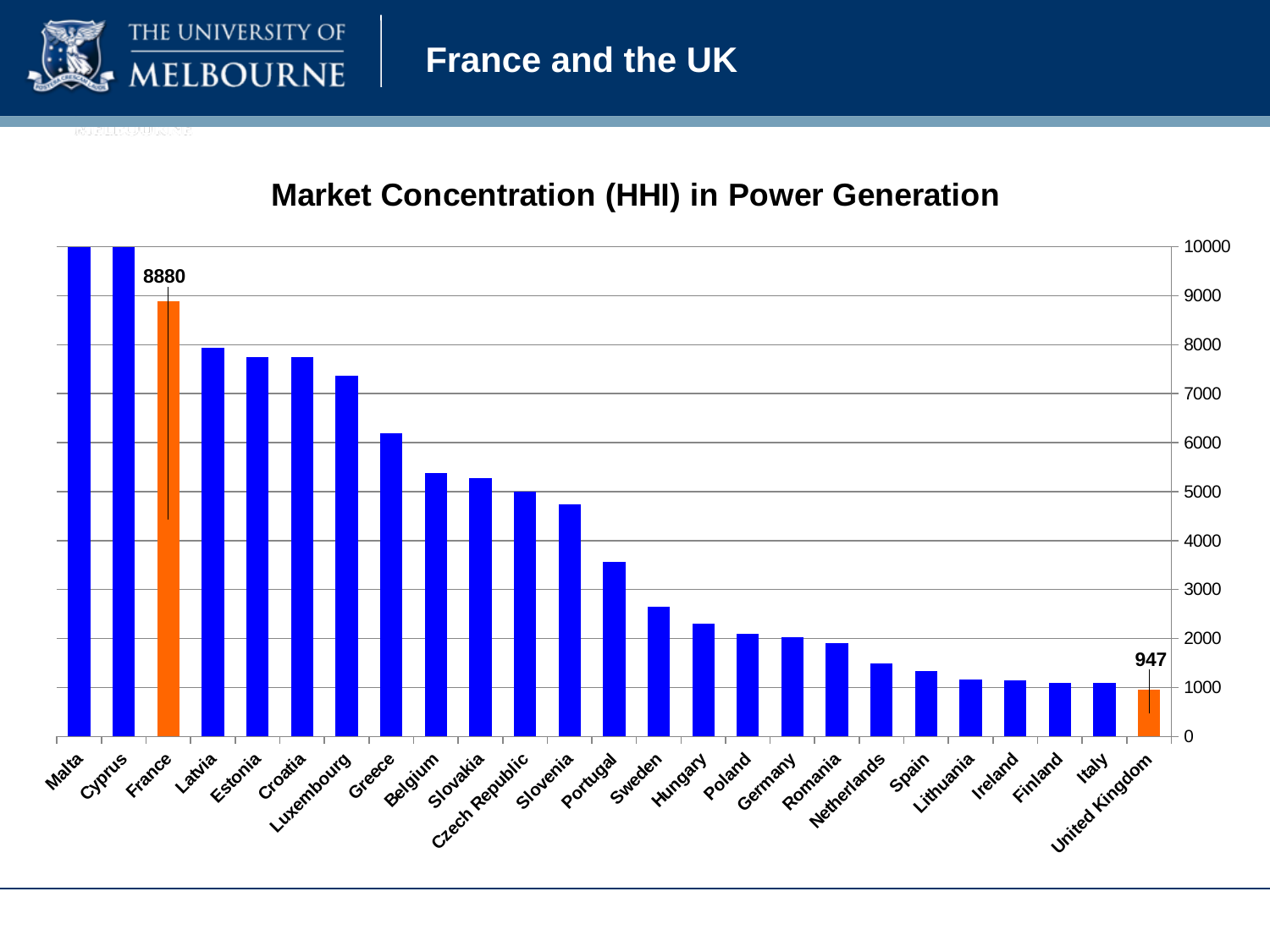
What is the HHI value shown for the United Kingdom? 947 What is the HHI value shown for France? 8880 Is the value for Latvia greater or less than 7000? greater What type of chart is shown on the slide? bar chart Is the value for Sweden greater or less than 3000? less What colour are the bars for France and the United Kingdom? orange What is the title of the chart? Market Concentration (HHI) in Power Generation Which country has the lowest HHI value in the chart? United Kingdom How many countries are shown in the chart? 25 Do the values generally rise or fall moving from left to right along the x axis? fall What is the difference between the HHI values of France and the United Kingdom? 7933 Which has a higher HHI value, Latvia or Greece? Latvia